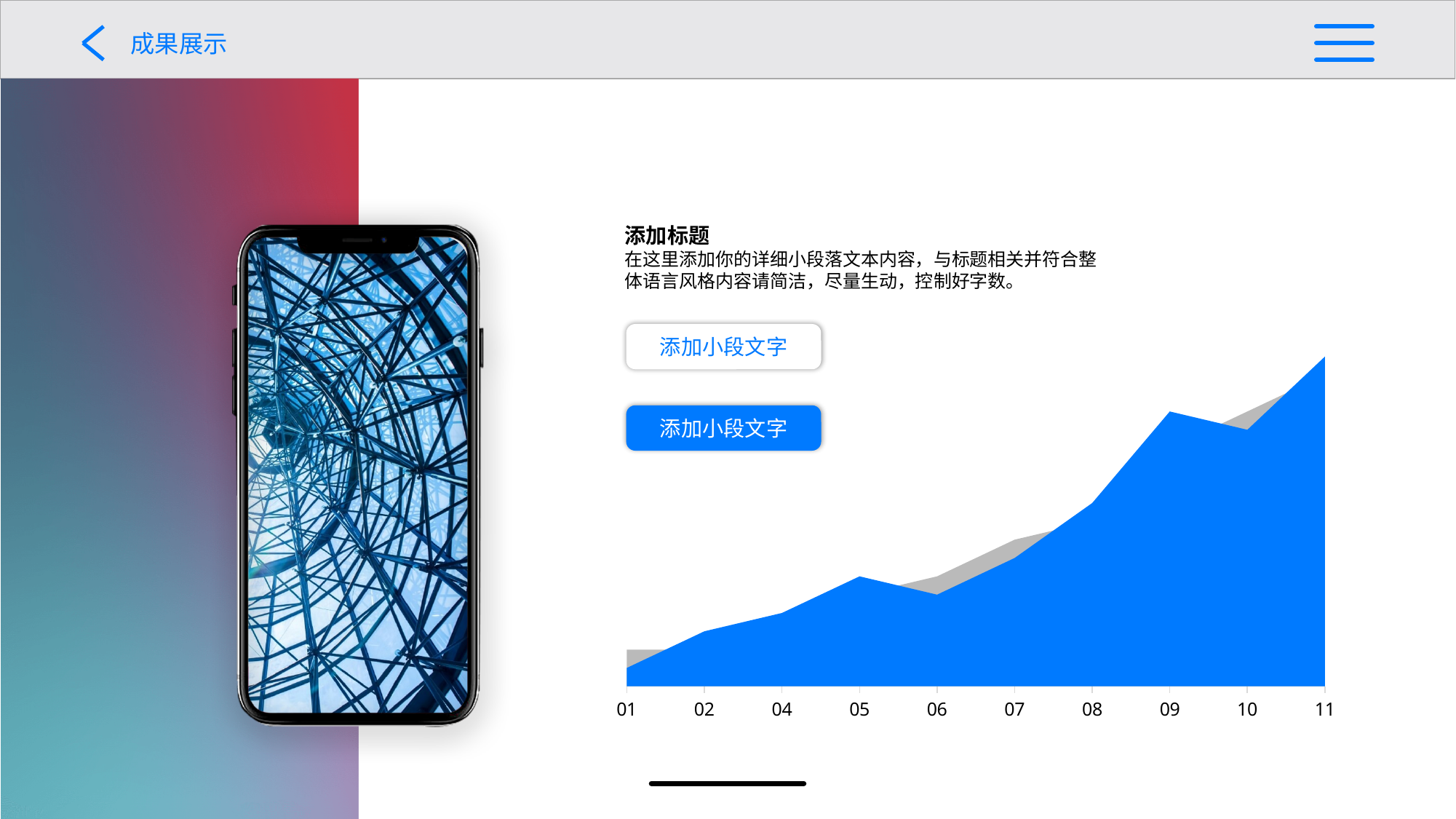
What is the first category label on the x axis of the chart? 01 Which category has the highest value for the blue series? 11 For the blue series, which is larger, the value at 09 or the value at 10? 09 What colour is the front (larger) area series in the chart? blue For the blue series, which is larger, the value at 08 or the value at 07? 08 Overall, do the values of the blue series rise or fall from 01 to 11? rise Which category has the lowest value for the blue series? 01 For the blue series, which is larger, the value at 05 or the value at 06? 05 How many categories are labelled on the x axis of the chart? 10 What kind of chart is shown on the slide? area chart